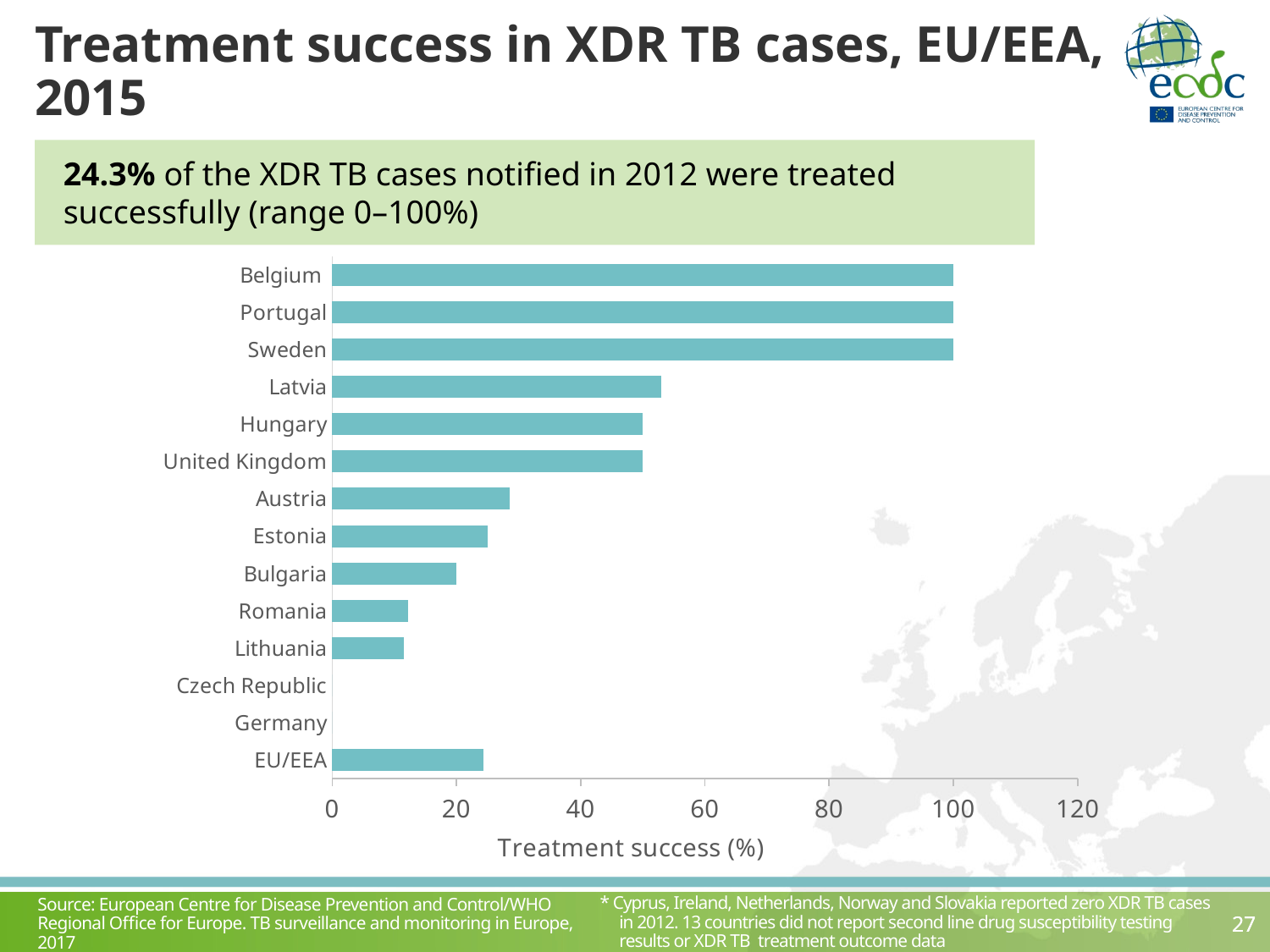
Which has the higher treatment success, Latvia or Austria? Latvia How many categories (countries plus EU/EEA) are plotted on the chart? 14 What is the treatment success value for Germany? 0 Which has the higher treatment success, Romania or Estonia? Estonia Which countries show no bar (a value of 0) on the chart? Czech Republic and Germany Is the value for Romania greater or less than 20? less What is the treatment success value for Sweden? 100 Is the value for Austria greater or less than 20? greater What is the treatment success value for Belgium? 100 What kind of chart is shown on the slide? bar chart Is the value for Latvia greater or less than 40? greater What is the label of the horizontal axis? Treatment success (%)